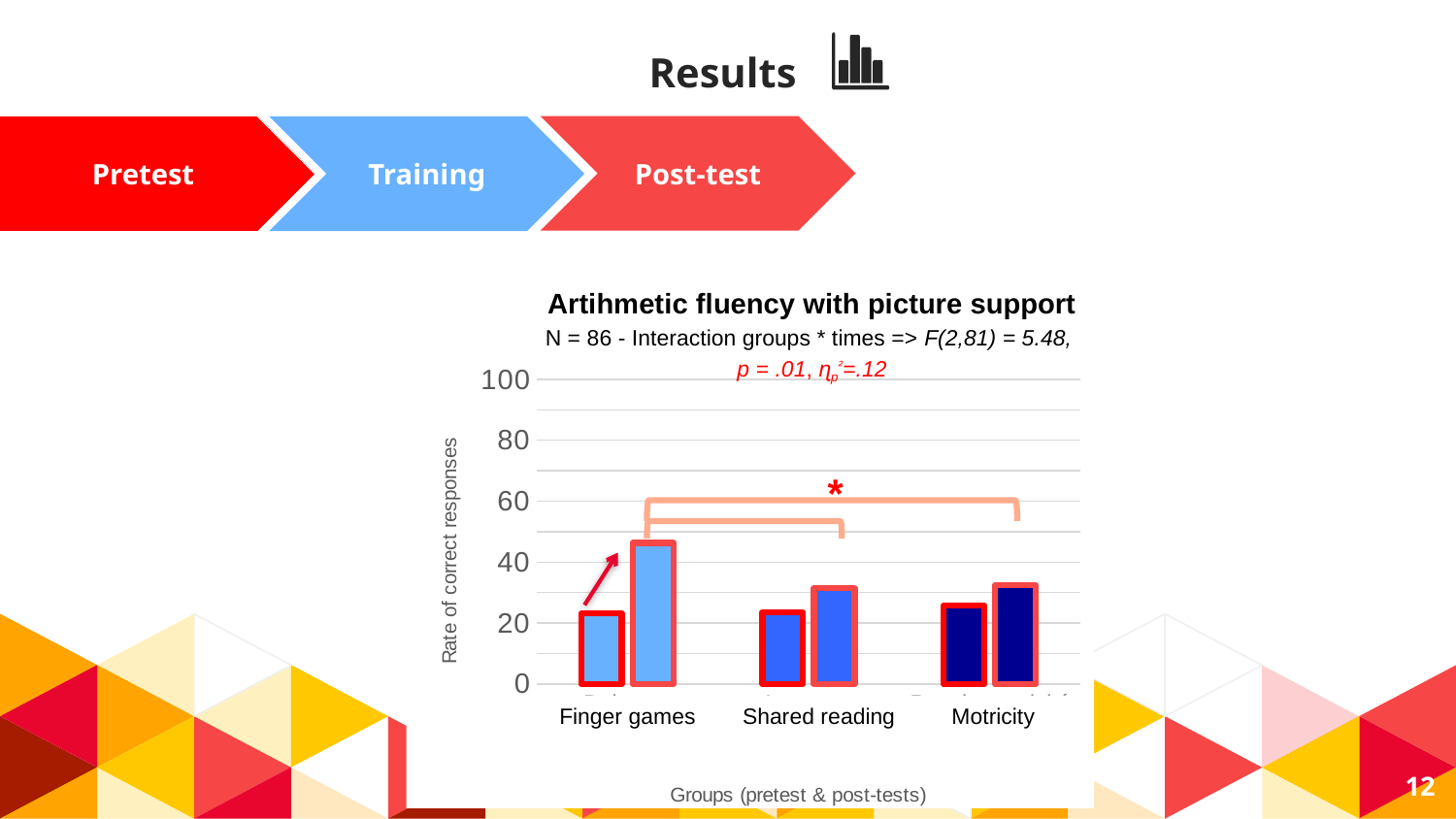
Is the post-test value for Finger games greater or less than 40? greater What is the label of the y axis? Rate of correct responses Is the pretest value for Finger games greater or less than 40? less For the Finger games group, does the value rise or fall from pretest to post-test? rise Which group has the tallest bar in the chart? Finger games Is the pretest value for Motricity greater or less than 20? greater How many bars are plotted in the chart in total? 6 What is the title of the chart? Artihmetic fluency with picture support How many groups are shown on the x axis of the chart? 3 What kind of chart is shown on the slide? bar chart Which is larger: the post-test bar for Finger games or the post-test bar for Shared reading? Finger games